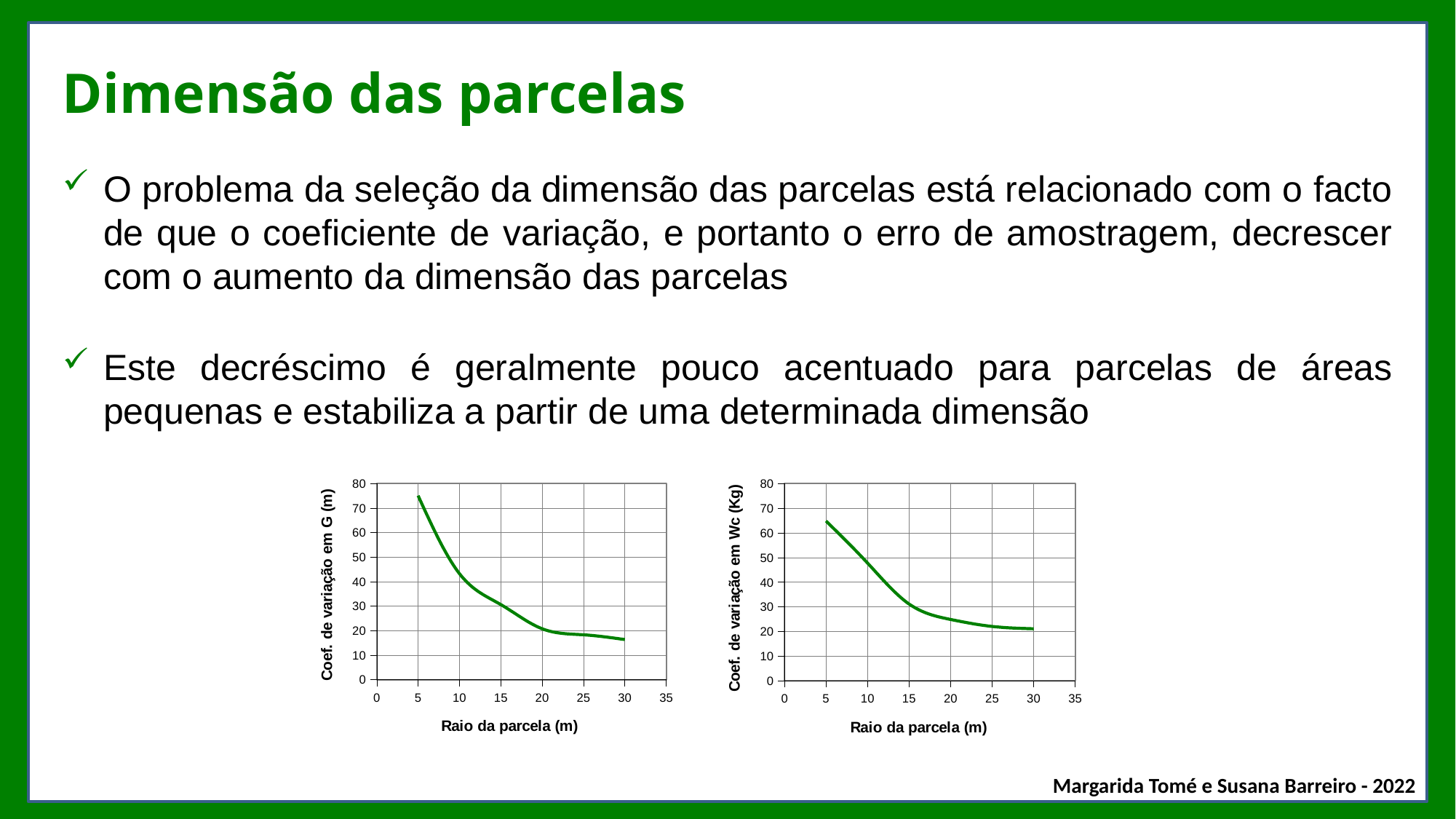
At a plot radius of 5 m, which chart shows the higher coefficient of variation, the left chart (G) or the right chart (Wc)? the left chart (G) In the right chart, is the coefficient of variation at a plot radius of 10 m greater or less than 50? less In the left chart, is the coefficient of variation at a plot radius of 30 m greater or less than 20? less In the right chart, is the coefficient of variation at a plot radius of 30 m greater or less than 30? less What is the y-axis label of the right chart? Coef. de variação em Wc (Kg) What kind of chart is the left chart on the slide? line chart What is the x-axis label of the left chart? Raio da parcela (m) In the left chart, does the coefficient of variation rise or fall as the plot radius increases? fall What kind of chart is the right chart on the slide? line chart In the right chart, does the coefficient of variation rise or fall as the plot radius increases? fall